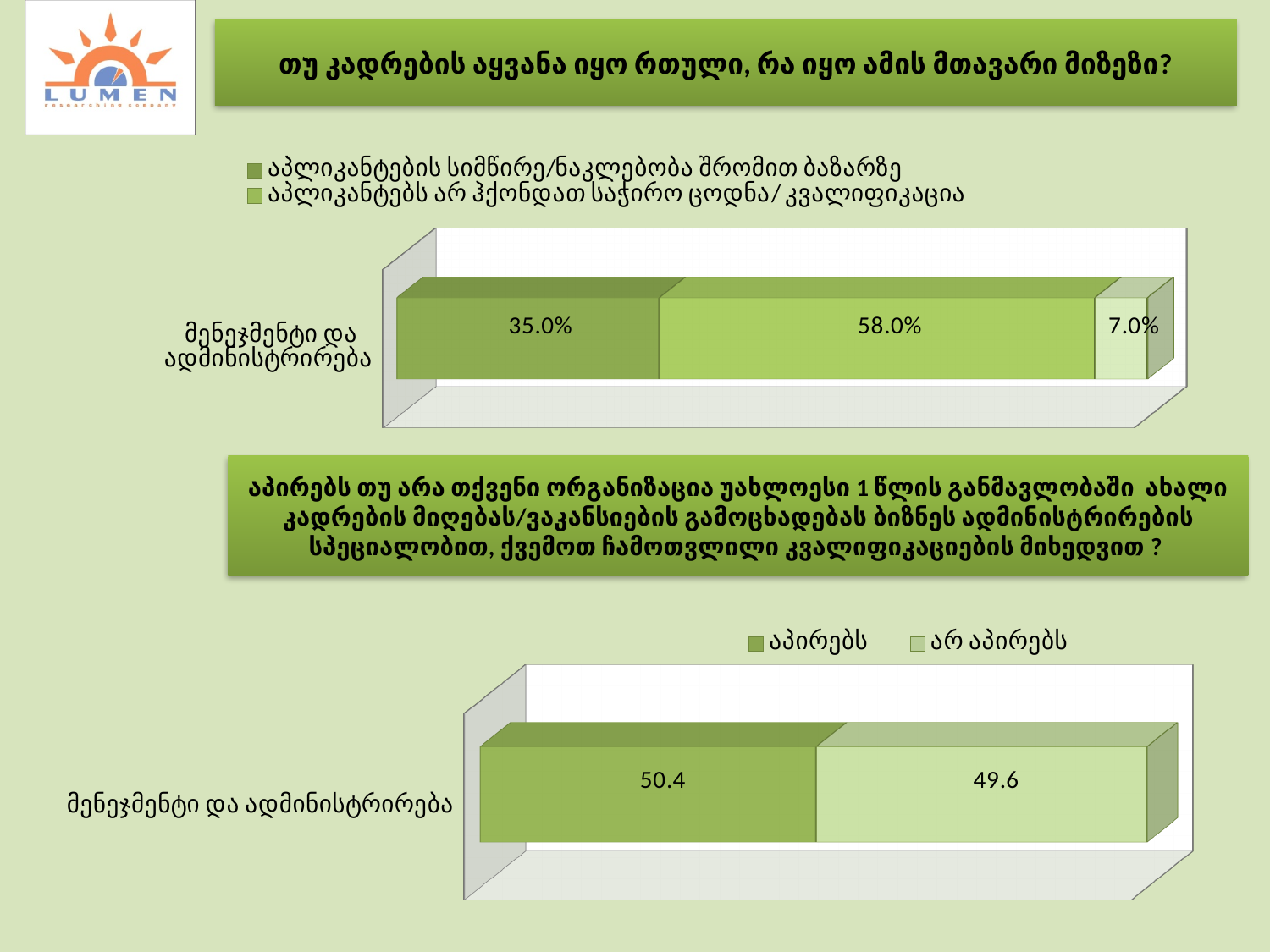
In the bottom chart, what is the total of the two segments of the bar? 100 How many series does the legend of the bottom chart list? 2 In the top chart, what is the total of all segments in the bar? 100.0% What type of chart is the top chart? Stacked bar chart In the bottom chart, what is the value for 'არ აპირებს'? 49.6 In the bottom chart, what is the difference between 'აპირებს' and 'არ აპირებს'? 0.8 In the top chart, what is the value of the segment for 'აპლიკანტების სიმწირე/ნაკლებობა შრომით ბაზარზე'? 35.0% In the top chart, which legend entry corresponds to the largest segment of the bar? აპლიკანტებს არ ჰქონდათ საჭირო ცოდნა/ კვალიფიკაცია In the bottom chart, what is the value for 'აპირებს'? 50.4 In the top chart, what is the value of the smallest segment of the bar? 7.0% In the top chart, what is the difference between the 58.0% segment and the 35.0% segment? 23.0% In the top chart, what is the value of the segment for 'აპლიკანტებს არ ჰქონდათ საჭირო ცოდნა/ კვალიფიკაცია'? 58.0%